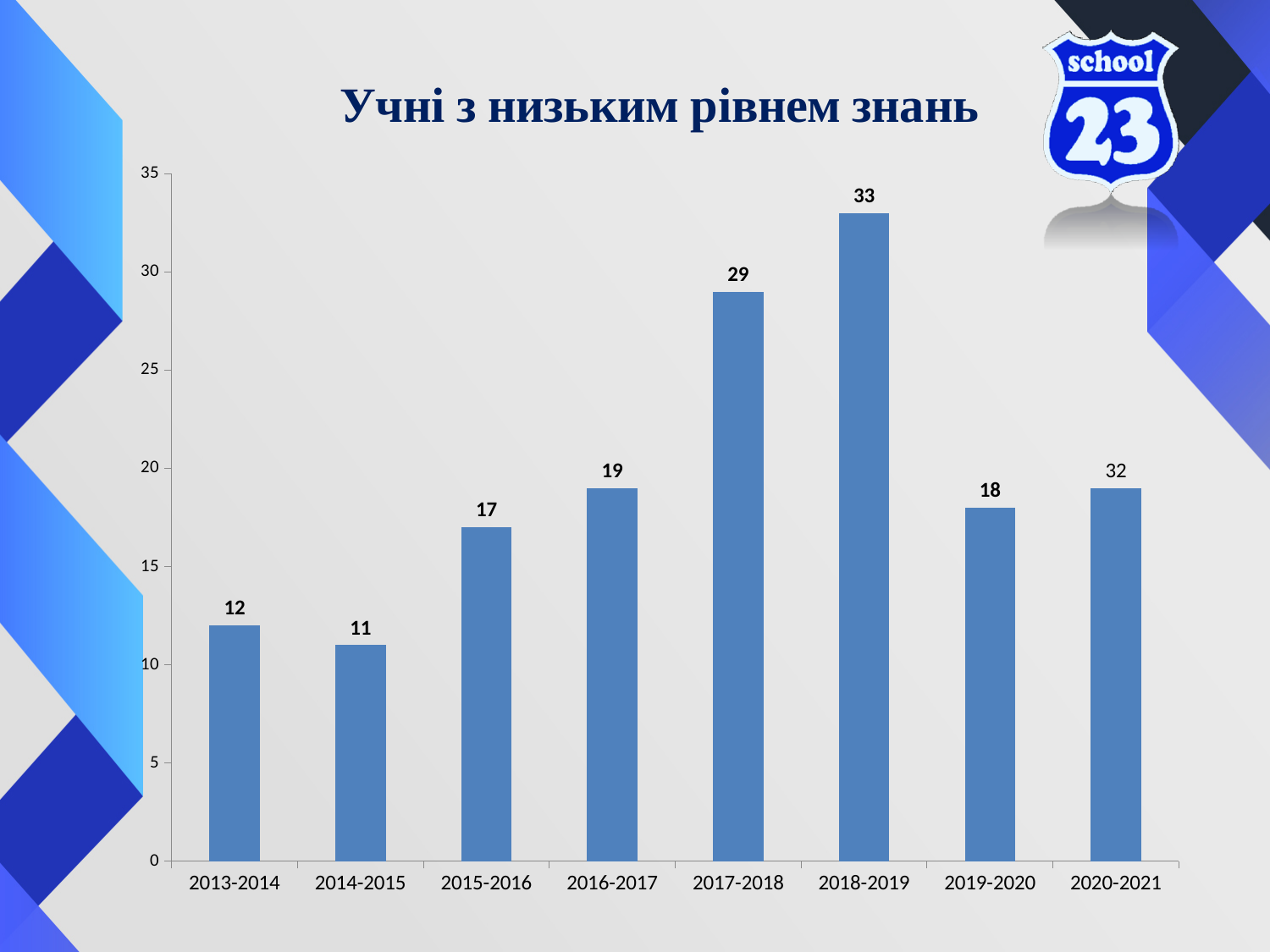
What is the title of the chart? Учні з низьким рівнем знань What is the value for 2019-2020? 18 What is the difference between the values for 2018-2019 and 2017-2018? 4 Which is larger, the value for 2016-2017 or the value for 2019-2020? 2016-2017 What type of chart is shown on the slide? bar chart Which school year has the highest value? 2018-2019 What is the value for 2013-2014? 12 What is the value for 2017-2018? 29 What is the value for 2015-2016? 17 How many school years (categories) are shown on the x axis? 8 Is the value for 2017-2018 greater or less than 25? greater Which school year has the lowest value? 2014-2015